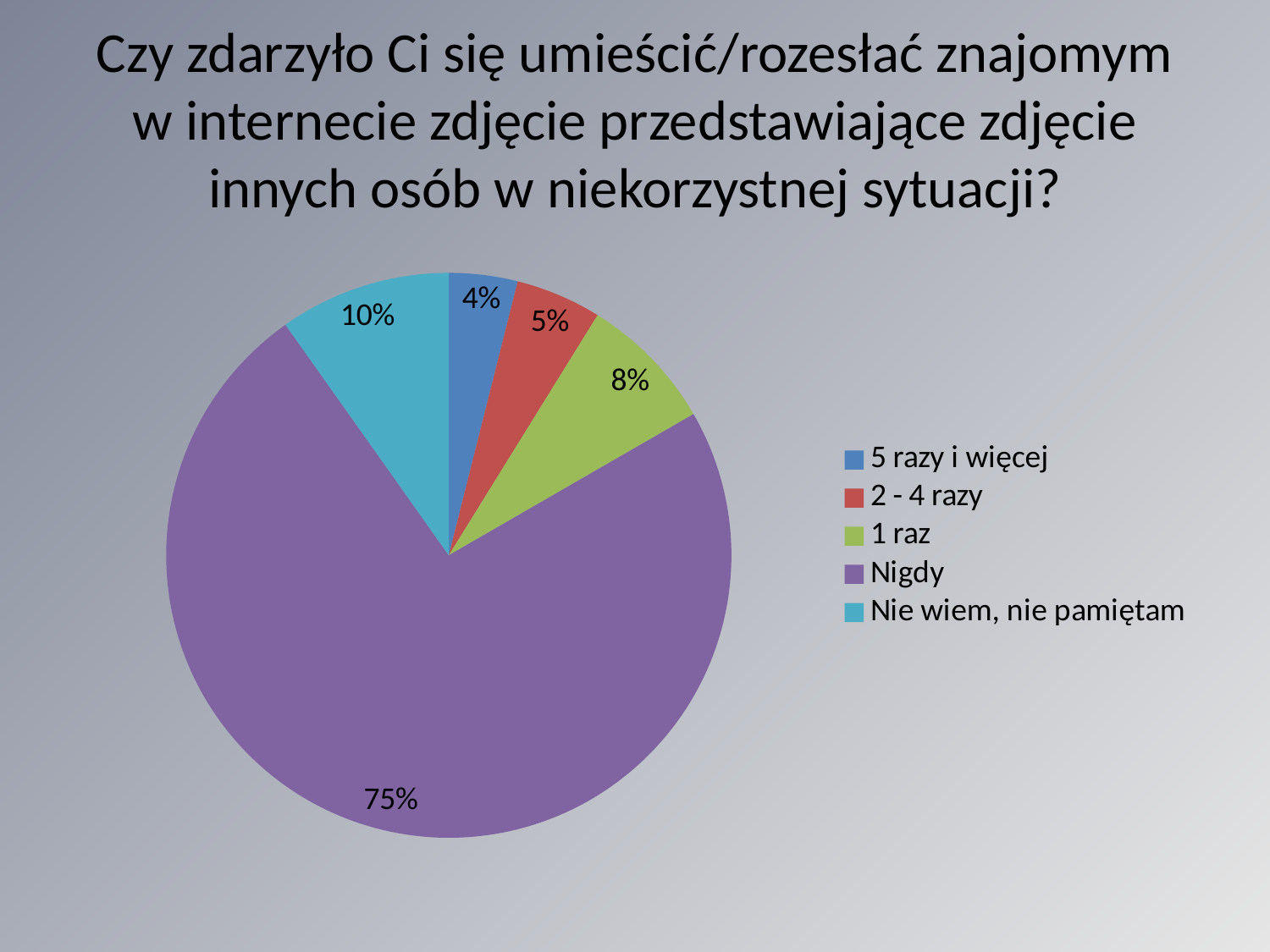
What is the value for "5 razy i więcej"? 4% What is the value for "2 - 4 razy"? 5% Which category has the smallest slice of the pie? 5 razy i więcej What kind of chart is shown on the slide? pie chart Which is larger, the value for "1 raz" or the value for "2 - 4 razy"? 1 raz What is the value for "Nie wiem, nie pamiętam"? 10% What share of the pie does "Nigdy" have? 75% What colour is the slice for "Nigdy"? purple How many categories does the pie chart have? 5 Which category has the largest slice of the pie? Nigdy What is the value for "1 raz"? 8% What is the difference between the values for "Nigdy" and "Nie wiem, nie pamiętam"? 65%